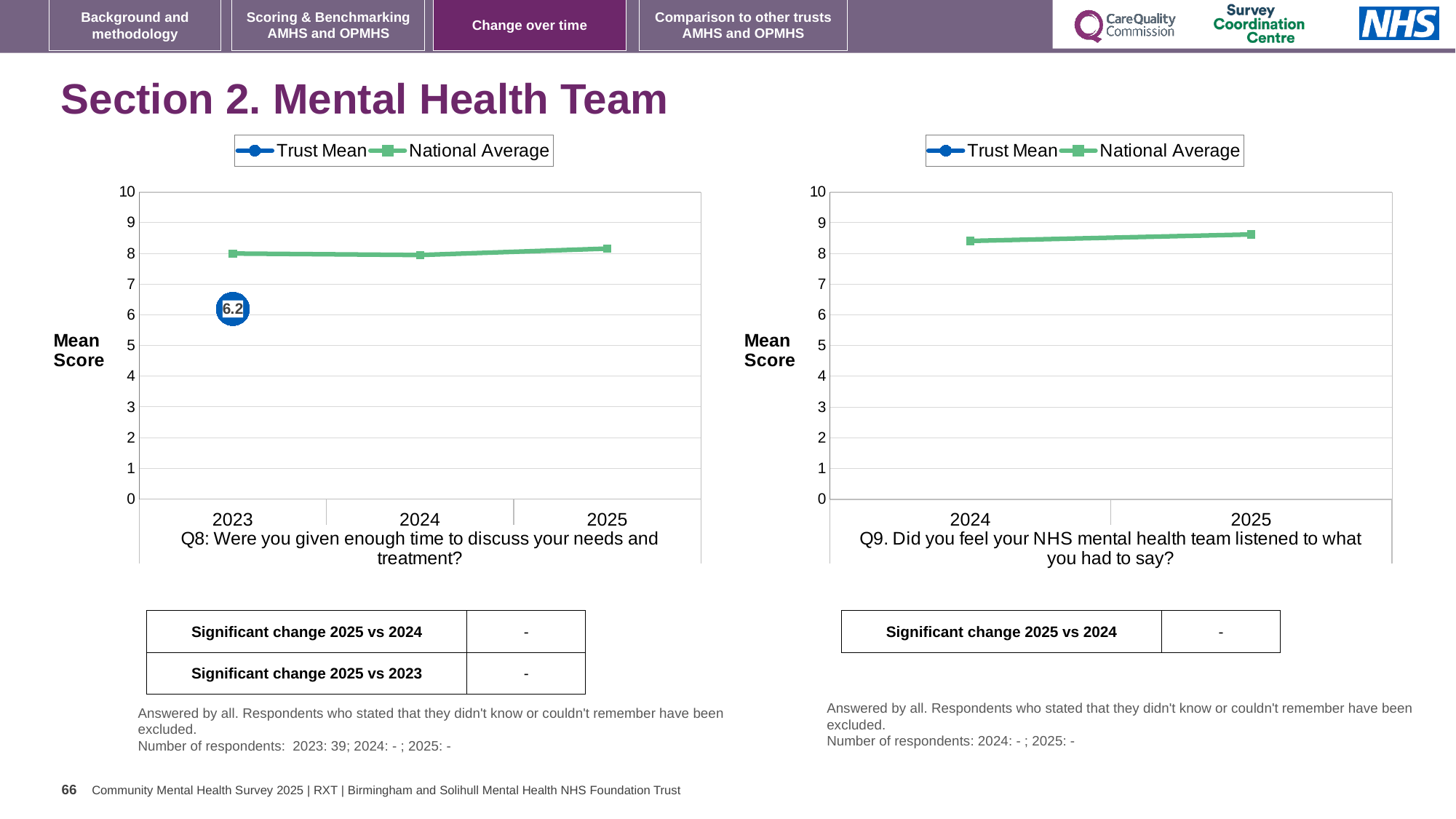
How many years are shown on the x axis of the right chart (Q9)? 2 On the left chart (Q8), what is the Trust Mean value for 2023? 6.2 What are the two legend entries on the left chart (Q8)? Trust Mean and National Average On the left chart (Q8), which is larger in 2023: the Trust Mean or the National Average? National Average On the right chart (Q9), does the National Average rise or fall from 2024 to 2025? rise How many series does the legend of the right chart (Q9) list? 2 What is the y-axis label on the right chart (Q9)? Mean Score On the right chart (Q9), is the National Average value for 2025 greater or less than 8? greater On the left chart (Q8), is the National Average value for 2023 greater or less than 7? greater How many years are shown on the x axis of the left chart (Q8)? 3 What kind of chart is the left chart (Q8)? line chart On the left chart (Q8), is the Trust Mean value for 2023 greater or less than 7? less